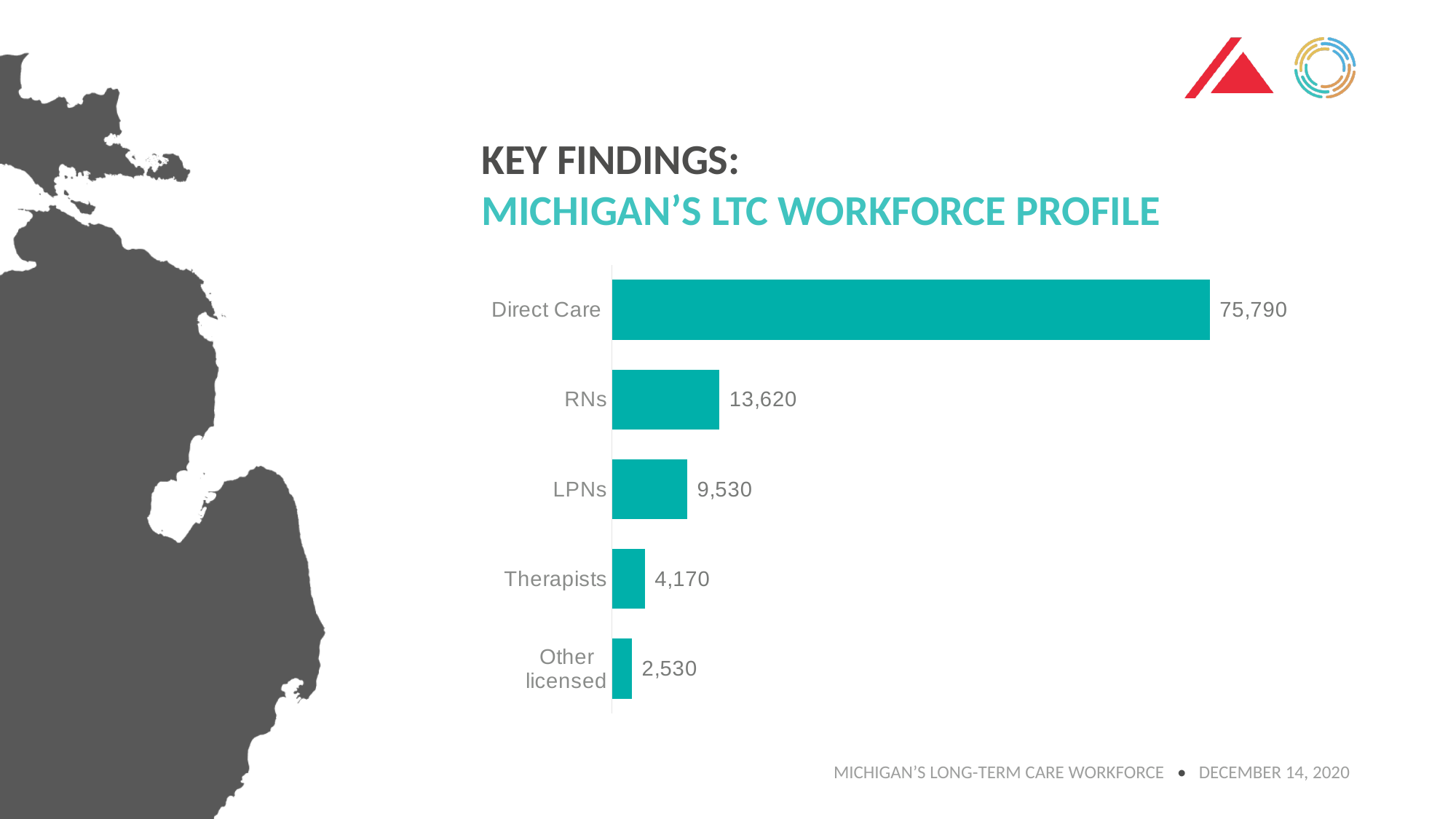
What is the value for Direct Care? 75,790 What is the value for Therapists? 4,170 Which category has the highest value? Direct Care What is the difference between the values for RNs and LPNs? 4,090 What is the value for RNs? 13,620 What kind of chart is shown on the slide? Bar chart What is the value for Other licensed? 2,530 Which is larger, the value for Therapists or the value for Other licensed? Therapists What is the value for LPNs? 9,530 Which category has the lowest value? Other licensed What is the difference between the values for Direct Care and RNs? 62,170 How many categories are shown in the chart? 5